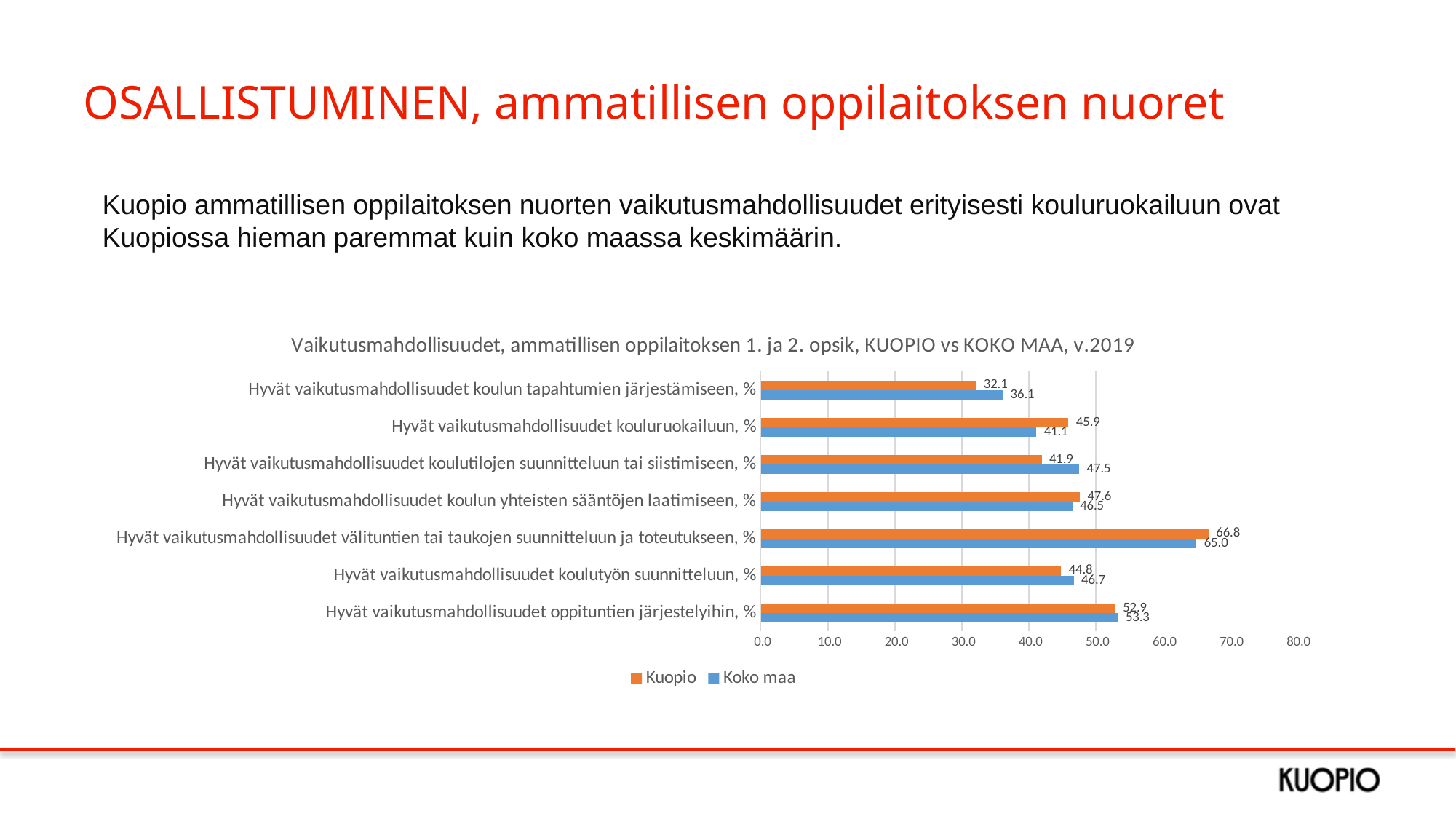
Is the Kuopio value for "Hyvät vaikutusmahdollisuudet oppituntien järjestelyihin, %" greater or less than 50.0? greater Which category has the lowest Koko maa value? Hyvät vaikutusmahdollisuudet koulun tapahtumien järjestämiseen, % What kind of chart is shown on the slide? Bar chart What is the Koko maa value for "Hyvät vaikutusmahdollisuudet koulutilojen suunnitteluun tai siistimiseen, %"? 47.5 How many series does the legend list? 2 How many categories are shown in the chart? 7 Which colour represents the Kuopio series in the chart? Orange What is the Koko maa value for "Hyvät vaikutusmahdollisuudet koulun tapahtumien järjestämiseen, %"? 36.1 Which category has the highest Kuopio value? Hyvät vaikutusmahdollisuudet välituntien tai taukojen suunnitteluun ja toteutukseen, % For "Hyvät vaikutusmahdollisuudet koulutyön suunnitteluun, %", which is larger: the Kuopio value or the Koko maa value? Koko maa What is the difference between the Kuopio and Koko maa values for "Hyvät vaikutusmahdollisuudet kouluruokailuun, %"? 4.8 What is the Kuopio value for "Hyvät vaikutusmahdollisuudet kouluruokailuun, %"? 45.9